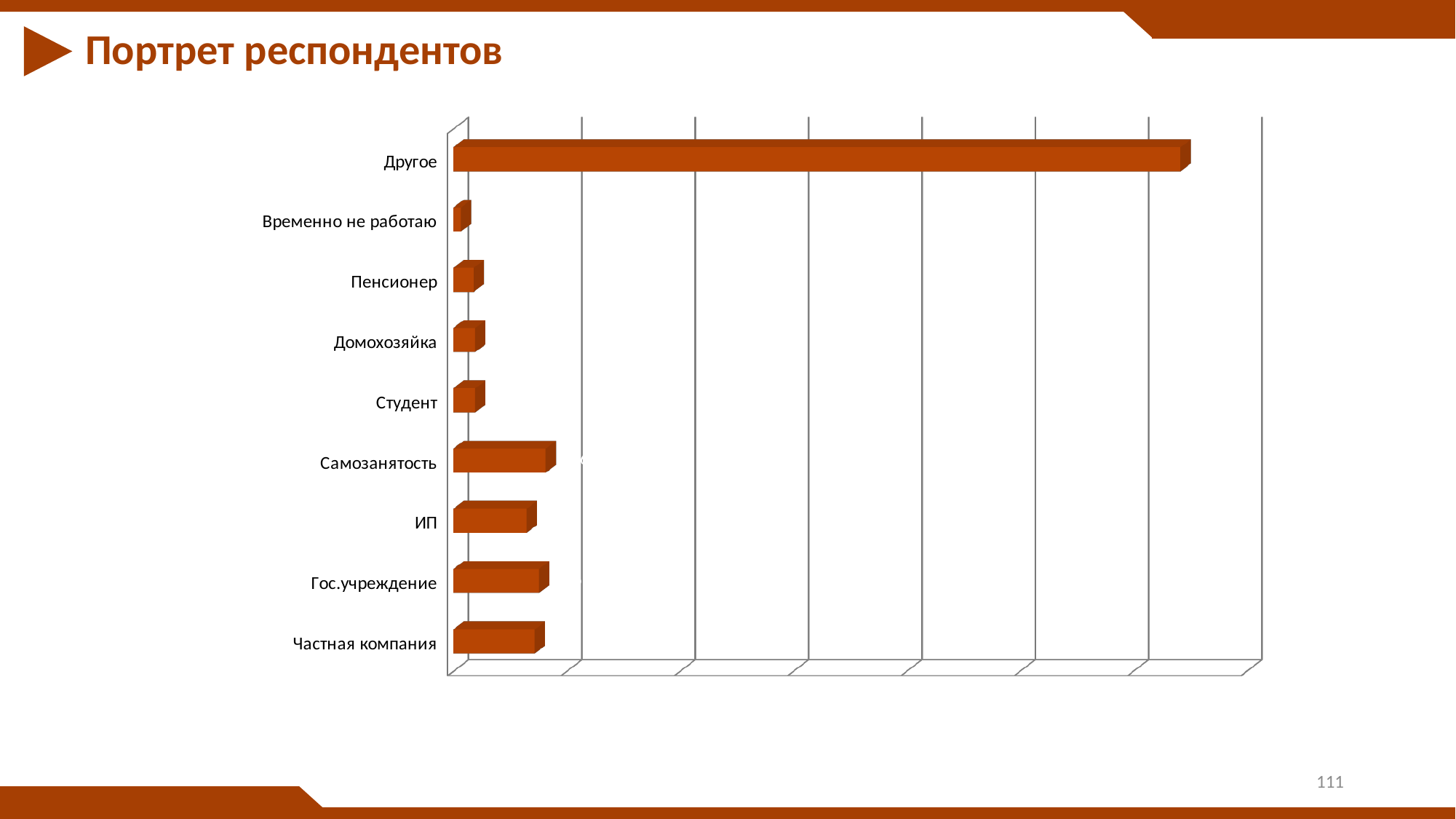
Which bar is longer: Другое or Самозанятость? Другое Which bar is longer: Гос.учреждение or Студент? Гос.учреждение Which category has the shortest bar in the chart? Временно не работаю What kind of chart is shown on the slide? bar chart How many categories are plotted in the chart? 9 What is the title of the slide containing the chart? Портрет респондентов Which bar is longer: Самозанятость or Студент? Самозанятость What colour are the bars in the chart? orange-brown Which category has the longest bar in the chart? Другое